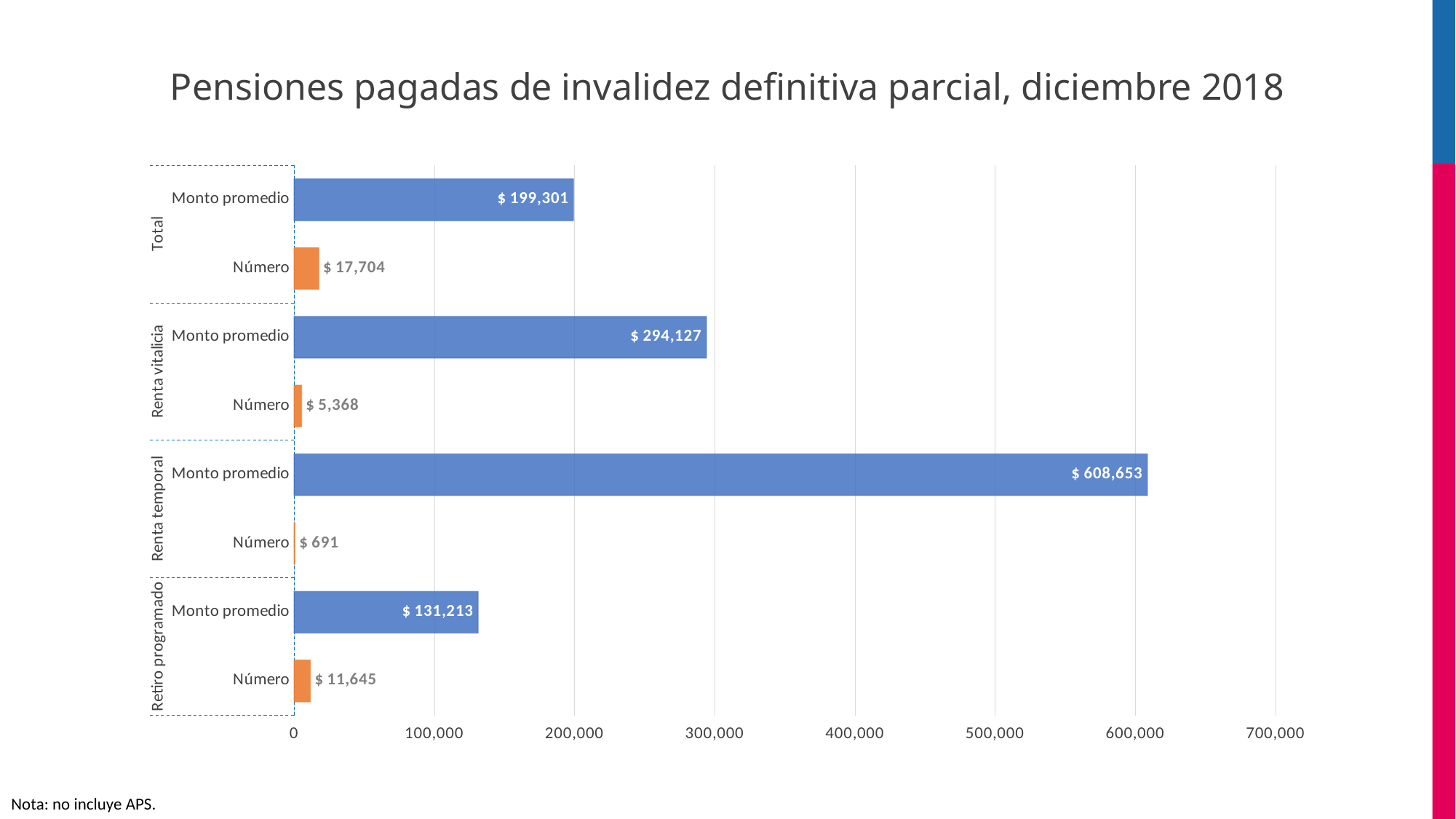
Which group has the highest Monto promedio? Renta temporal How many bars are plotted in the chart? 8 Which is larger, the Número for Retiro programado or the Número for Renta vitalicia? Retiro programado What is the Número for Total? $ 17,704 What is the Monto promedio for Renta temporal? $ 608,653 Is the Monto promedio for Total greater or less than 200,000? less Which group has the lowest Número? Renta temporal What is the title of the chart? Pensiones pagadas de invalidez definitiva parcial, diciembre 2018 What is the difference between the Monto promedio for Renta vitalicia and for Retiro programado? $ 162,914 What is the Número for Renta vitalicia? $ 5,368 What kind of chart is shown on the slide? bar chart What is the Monto promedio for Retiro programado? $ 131,213